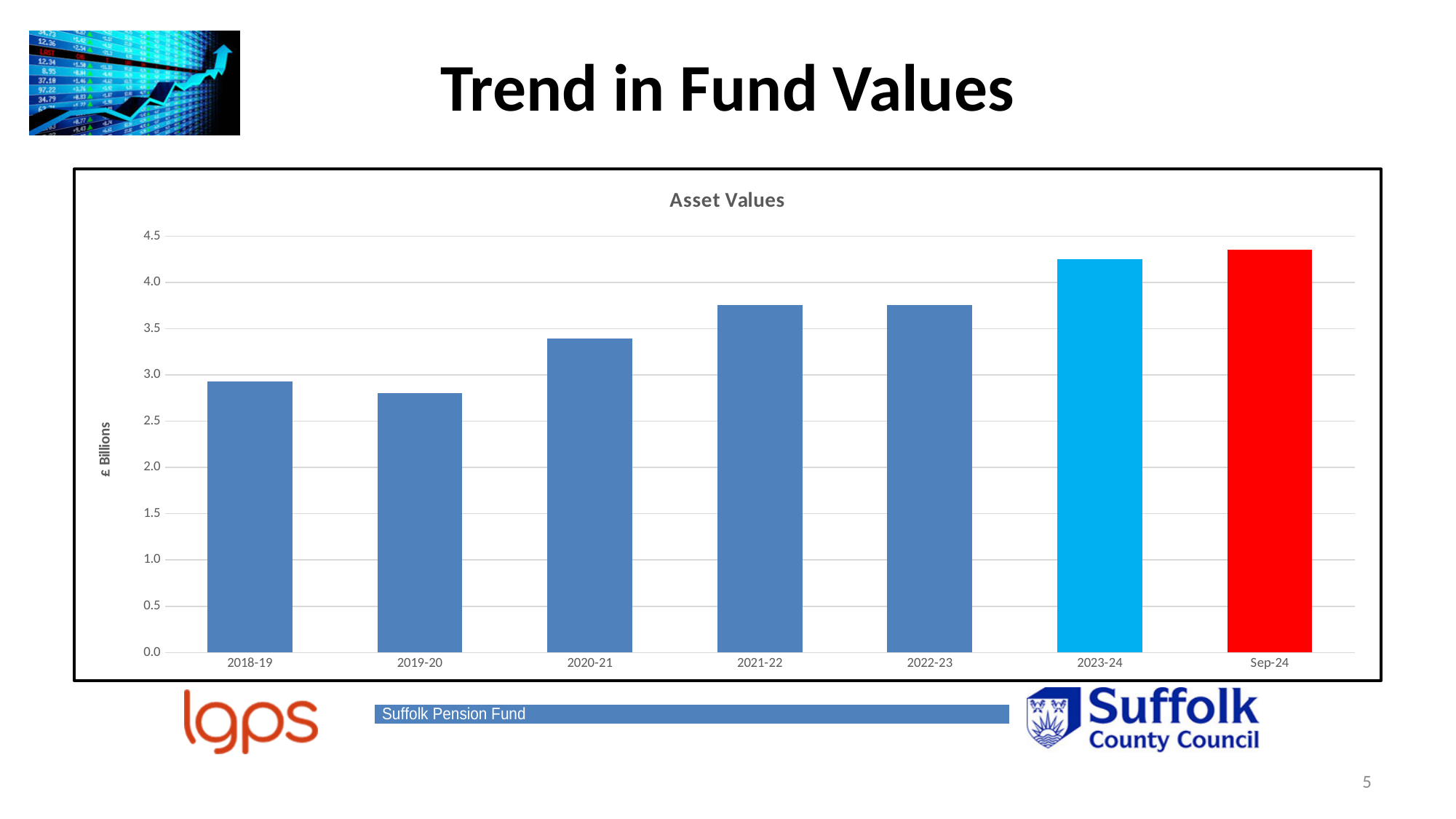
What is the title of the chart? Asset Values Is the asset value for 2022-23 greater or less than 4.0? less How many periods (bars) are shown on the chart? 7 Which is larger, the asset value for 2020-21 or for 2021-22? 2021-22 Is the asset value for 2023-24 greater or less than 4.0? greater What is the label on the vertical axis of the chart? £ Billions Is the asset value for 2020-21 greater or less than 3.0? greater Which period has the lowest asset value? 2019-20 Do the asset values generally rise or fall from 2019-20 to Sep-24? rise Which period has the highest asset value? Sep-24 What type of chart is shown on the slide? Bar chart